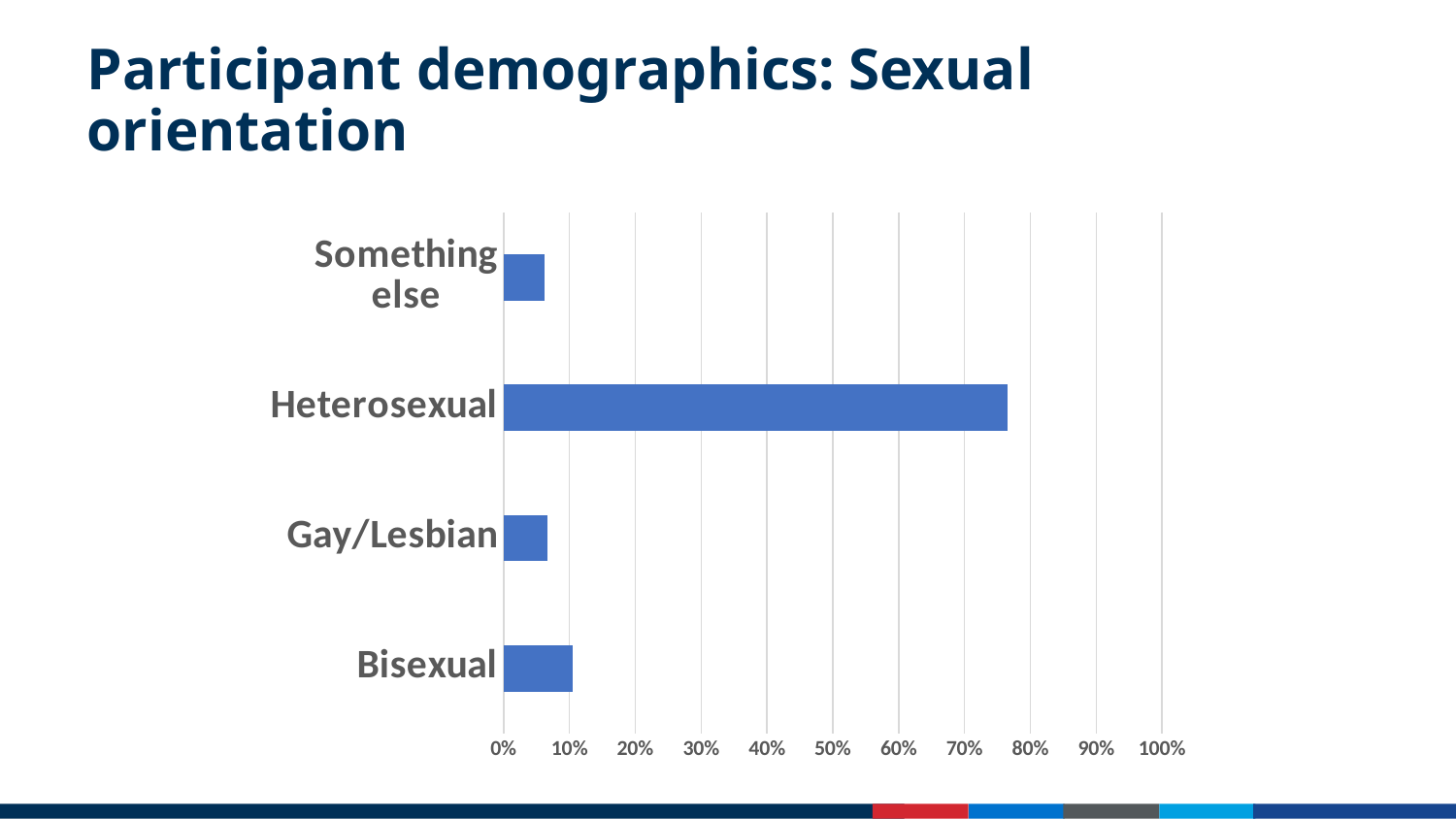
Is the value for Gay/Lesbian greater or less than 10%? less What is the title of the slide containing the chart? Participant demographics: Sexual orientation What kind of chart is shown on the slide? Bar chart Is the value for Heterosexual greater or less than 80%? less Which is larger, the value for Heterosexual or the value for Bisexual? Heterosexual Which is larger, the value for Bisexual or the value for Gay/Lesbian? Bisexual Is the value for Something else greater or less than 10%? less What is the highest value shown on the chart's horizontal axis? 100% How many sexual orientation categories are plotted in the chart? 4 Which category has the highest value in the chart? Heterosexual